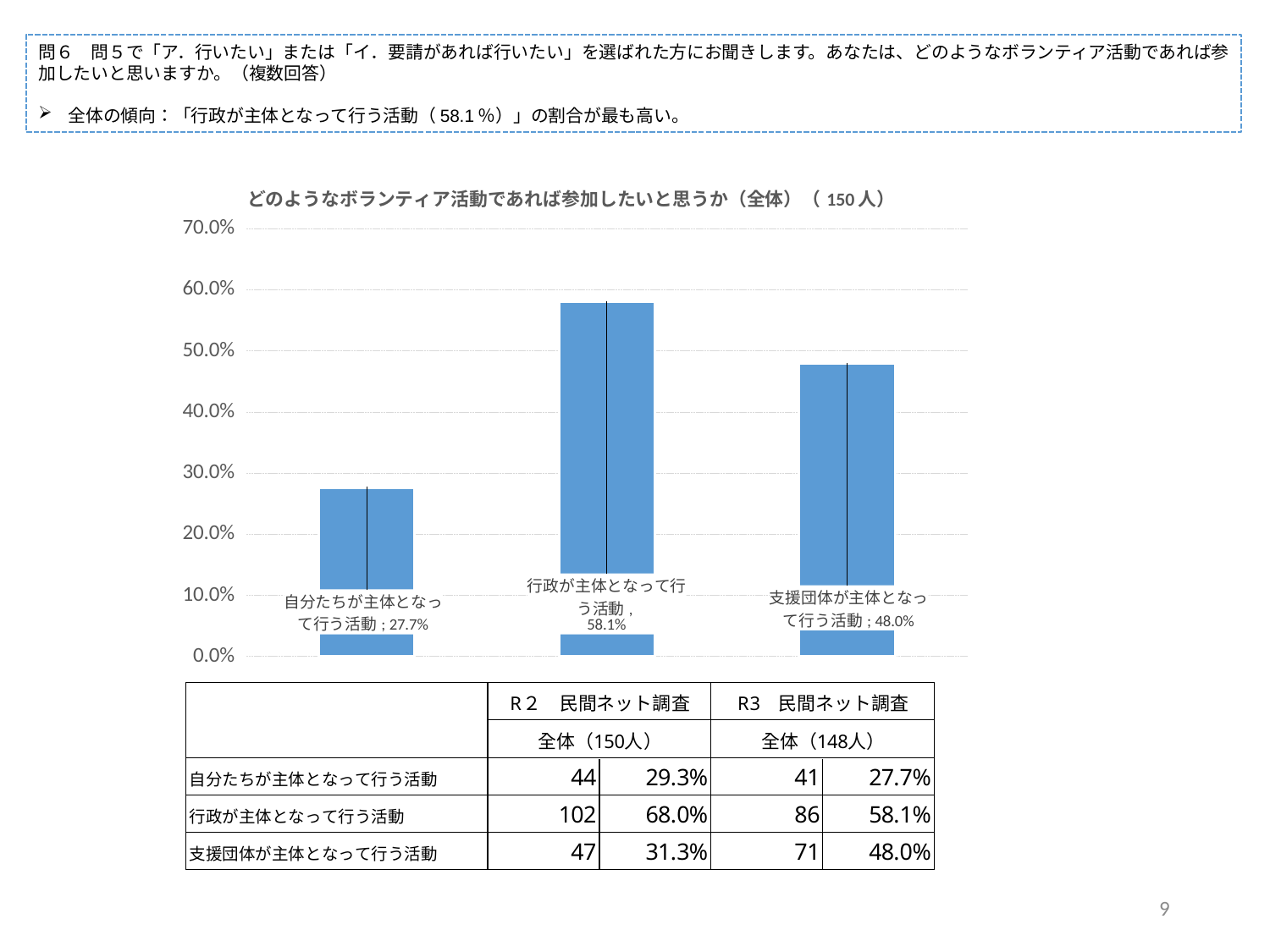
Which category has the highest value? 行政が主体となって行う活動 Which is larger, the value for 支援団体が主体となって行う活動 or the value for 自分たちが主体となって行う活動? 支援団体が主体となって行う活動 What is the value for 自分たちが主体となって行う活動? 27.7% What is the title of the chart? どのようなボランティア活動であれば参加したいと思うか（全体）（150人） What kind of chart is shown on the slide? bar chart What is the value for 支援団体が主体となって行う活動? 48.0% What is the difference between the values for 支援団体が主体となって行う活動 and 自分たちが主体となって行う活動? 20.3% What is the difference between the values for 行政が主体となって行う活動 and 支援団体が主体となって行う活動? 10.1% How many categories are shown in the chart? 3 Is the value for 行政が主体となって行う活動 greater or less than 50.0%? greater What is the value for 行政が主体となって行う活動? 58.1% Which category has the lowest value? 自分たちが主体となって行う活動